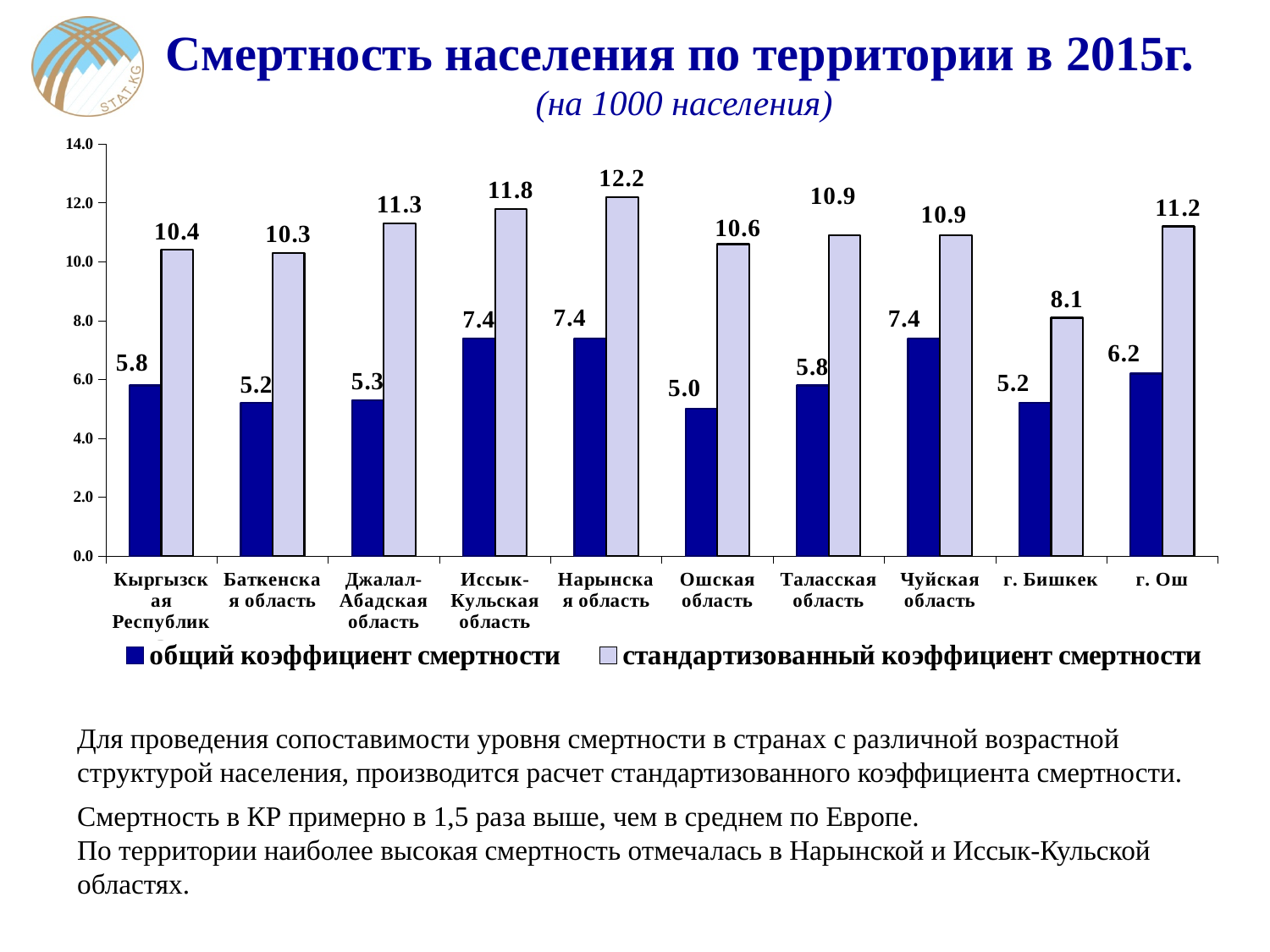
What is the difference between the стандартизованный and общий коэффициент смертности for г. Ош? 5.0 What is the стандартизованный коэффициент смертности for г. Бишкек? 8.1 Which is larger: the общий коэффициент смертности for г. Ош or for Баткенская область? г. Ош What kind of chart is shown on the slide? Bar chart What is the общий коэффициент смертности for Нарынская область? 7.4 Which territory has the lowest стандартизованный коэффициент смертности? г. Бишкек Which territory has the highest стандартизованный коэффициент смертности? Нарынская область Which territory has the lowest общий коэффициент смертности? Ошская область How many territories are shown on the x axis? 10 What is the стандартизованный коэффициент смертности for Кыргызская Республика? 10.4 Which series is shown in dark blue? общий коэффициент смертности How many series does the legend list? 2